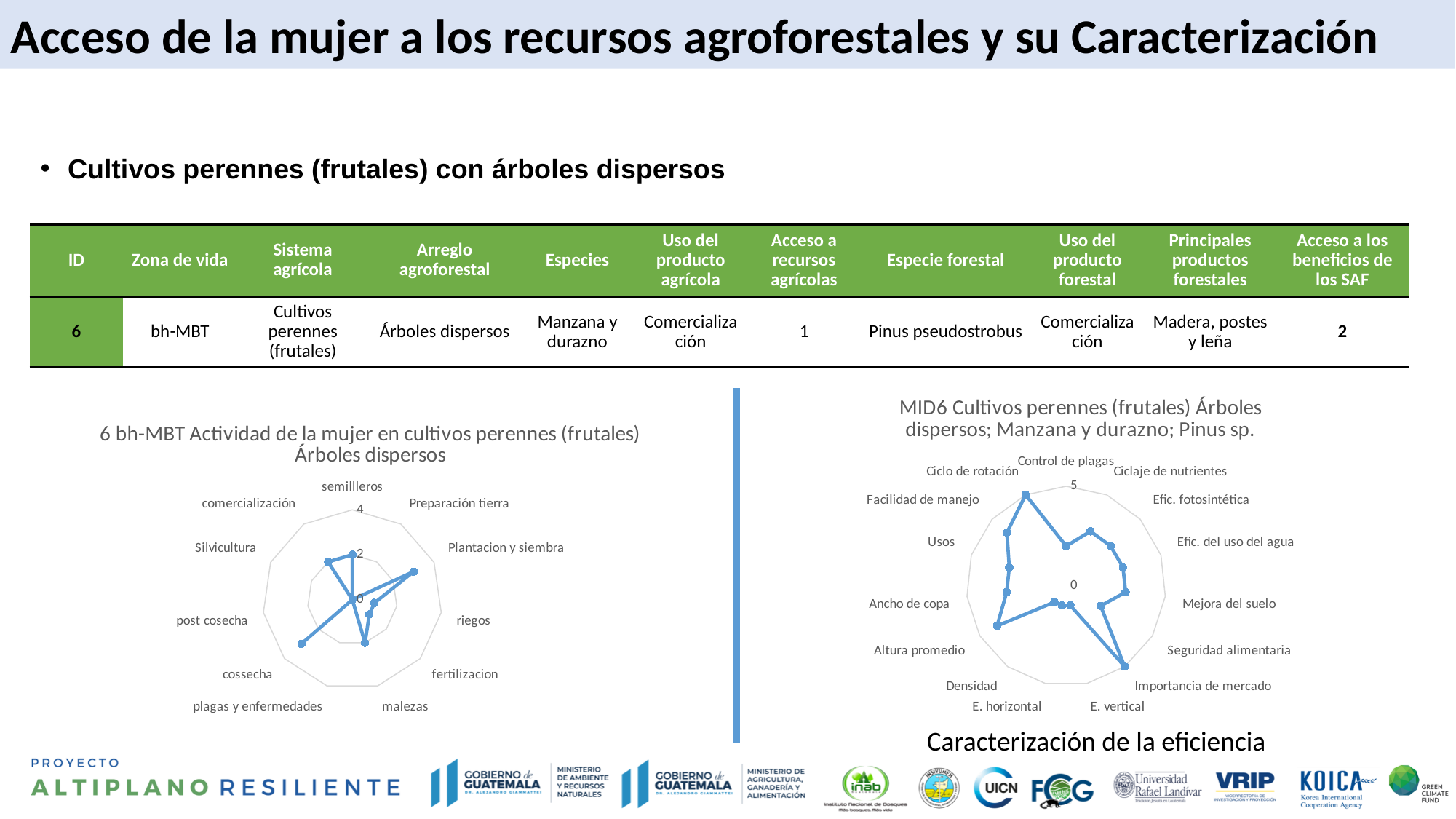
On the left chart, is the value for 'fertilizacion' greater or less than 2? less On the left chart, is the value for 'riegos' greater or less than 2? less What is the highest axis tick value shown on the right chart? 5 How many categories are plotted on the right chart 'MID6 Cultivos perennes (frutales) Árboles dispersos; Manzana y durazno; Pinus sp.'? 15 On the right chart, is the value for 'E. vertical' greater or less than 5? less What is the highest axis tick value shown on the left chart? 4 How many categories are plotted on the left chart '6 bh-MBT Actividad de la mujer en cultivos perennes (frutales) Árboles dispersos'? 11 What kind of chart is the left chart titled '6 bh-MBT Actividad de la mujer en cultivos perennes (frutales) Árboles dispersos'? Radar chart What kind of chart is the right chart titled 'MID6 Cultivos perennes (frutales) Árboles dispersos; Manzana y durazno; Pinus sp.'? Radar chart